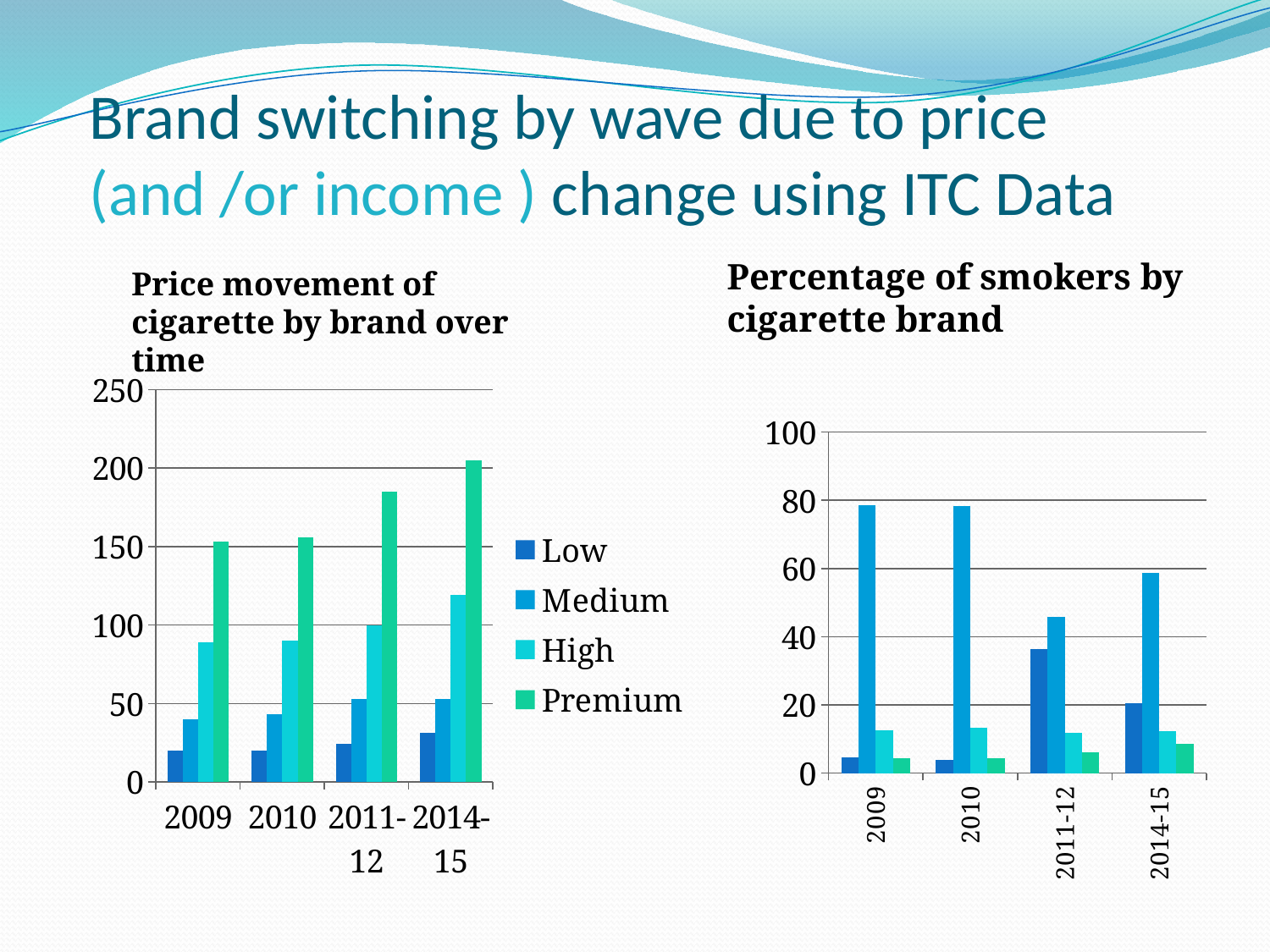
How many series does the legend of the 'Price movement of cigarette by brand over time' chart list? 4 How many categories are shown on the x axis of the 'Percentage of smokers by cigarette brand' chart? 4 In the 'Price movement of cigarette by brand over time' chart, which series has the shortest bar in 2010? Low What kind of chart is the 'Price movement of cigarette by brand over time' chart? bar chart In the 'Price movement of cigarette by brand over time' chart, is the Premium value for 2014-15 greater or less than 200? greater In the 'Price movement of cigarette by brand over time' chart, does the Premium series rise or fall from 2009 to 2014-15? rise In the 'Price movement of cigarette by brand over time' chart, which series has the tallest bar in 2014-15? Premium In the 'Price movement of cigarette by brand over time' chart, is the Low value for 2009 greater or less than 50? less In the 'Percentage of smokers by cigarette brand' chart, does the tallest bar in each group rise or fall from 2009 to 2014-15? fall In the 'Percentage of smokers by cigarette brand' chart, is the tallest bar for 2009 greater or less than 60? greater